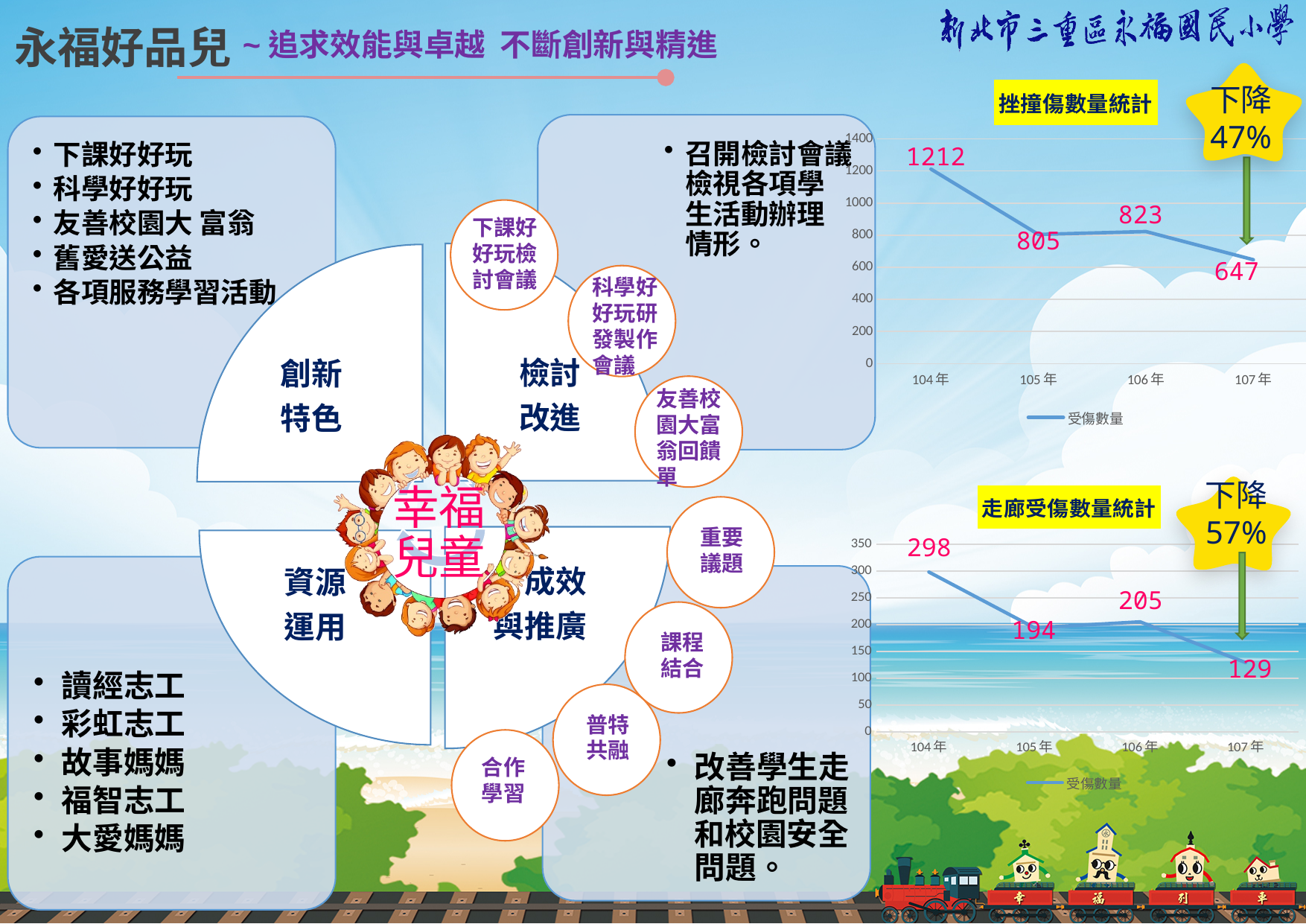
In the 走廊受傷數量統計 chart, which year has the lowest value? 107 年 What series name does the legend of the 走廊受傷數量統計 chart show? 受傷數量 In the 挫撞傷數量統計 chart, which year has the highest value? 104 年 In the 走廊受傷數量統計 chart, what is the value for 105 年? 194 In the 挫撞傷數量統計 chart, how many data points are plotted? 4 In the 挫撞傷數量統計 chart, what is the value for 104 年? 1212 In the 走廊受傷數量統計 chart, what is the overall trend of the values from 104 年 to 107 年? falling In the 挫撞傷數量統計 chart, what is the value for 107 年? 647 In the 走廊受傷數量統計 chart, what is the difference between the values for 104 年 and 107 年? 169 In the 走廊受傷數量統計 chart, which is larger, the value for 105 年 or 106 年? 106 年 What type of chart is the 挫撞傷數量統計 chart? line chart In the 挫撞傷數量統計 chart, what is the difference between the values for 104 年 and 107 年? 565